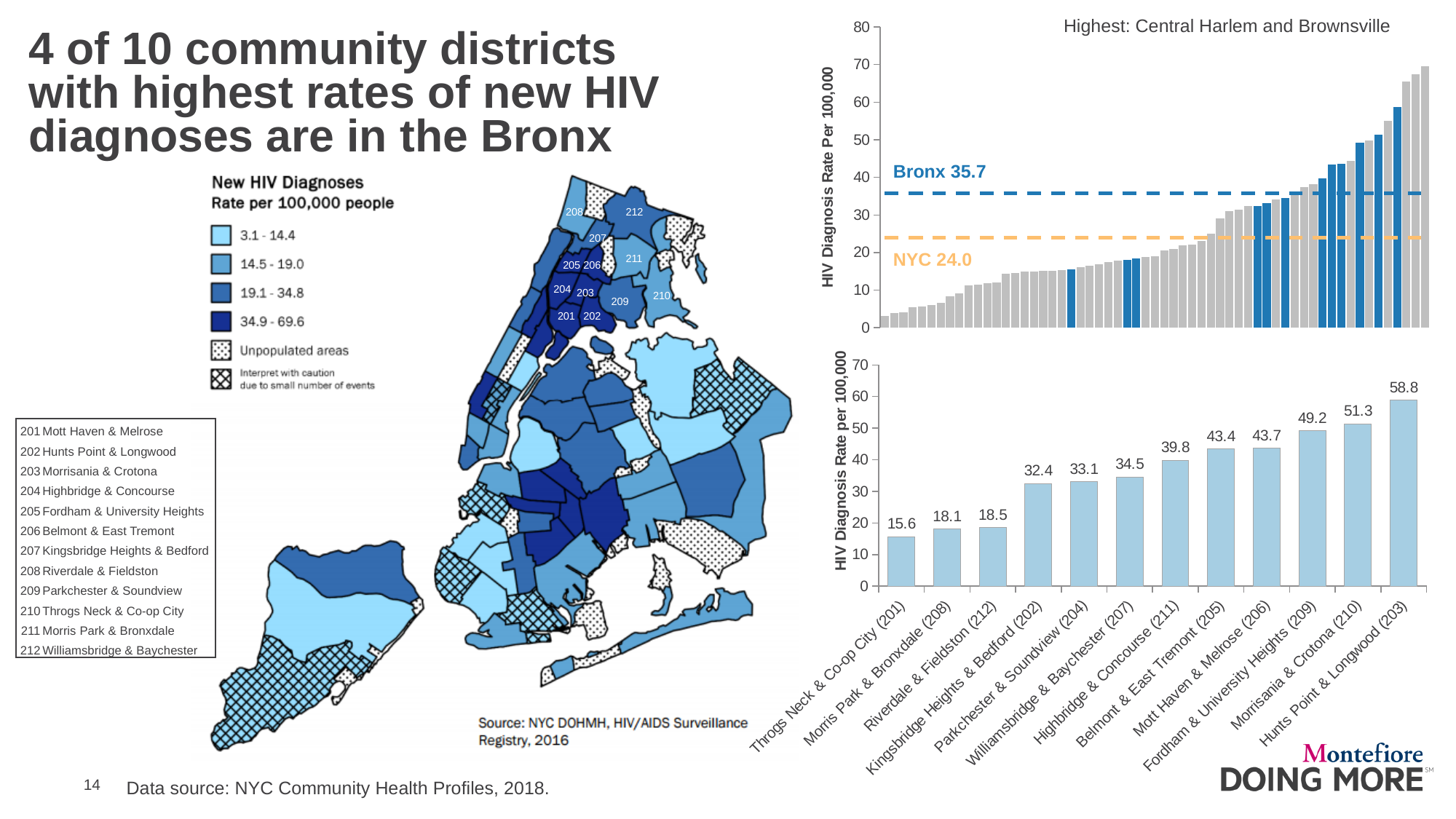
How many community districts are shown in the bottom chart? 12 In the bottom chart, which community district has the lowest HIV diagnosis rate? Throgs Neck & Co-op City (201) In the bottom chart, do the values rise or fall from left to right along the x axis? Rise In the bottom chart, what is the HIV diagnosis rate per 100,000 for Hunts Point & Longwood (203)? 58.8 In the bottom chart, what is the HIV diagnosis rate per 100,000 for Kingsbridge Heights & Bedford (202)? 32.4 In the bottom chart, which community district has the highest HIV diagnosis rate? Hunts Point & Longwood (203) What type of chart is the bottom chart on the right of the slide? Bar chart In the top chart, what value is marked by the Bronx dashed reference line? 35.7 In the bottom chart, which has a higher HIV diagnosis rate: Fordham & University Heights or Highbridge & Concourse? Fordham & University Heights In the top chart, what value is marked by the NYC dashed reference line? 24.0 In the bottom chart, what is the difference between the rates for Hunts Point & Longwood and Throgs Neck & Co-op City? 43.2 In the bottom chart, what is the difference between the rates for Mott Haven & Melrose and Belmont & East Tremont? 0.3